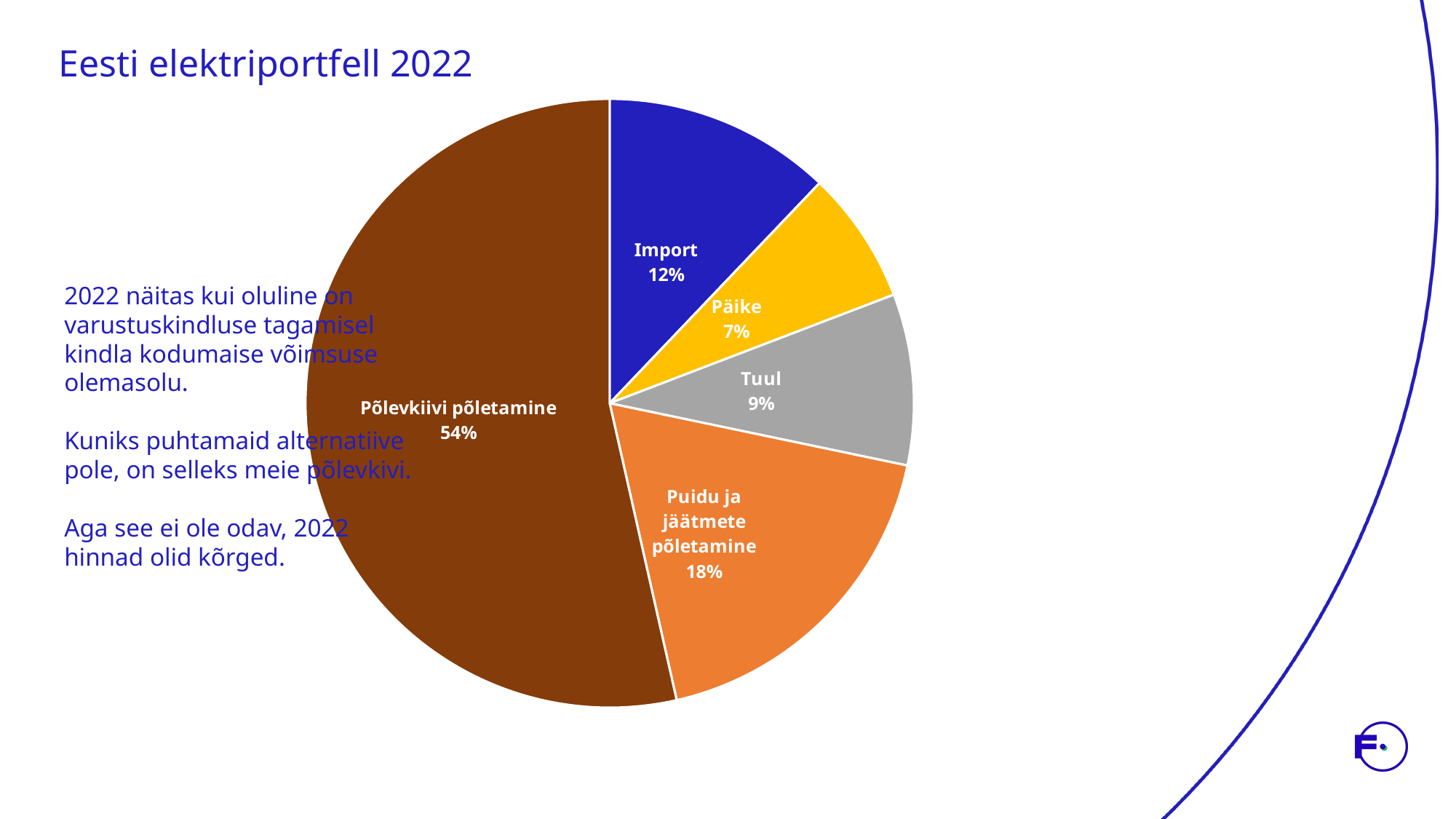
What is the value shown for Puidu ja jäätmete põletamine? 18% Which category has the largest slice of the pie? Põlevkiivi põletamine Which is larger, the share for Tuul or the share for Päike? Tuul What share of the pie does Põlevkiivi põletamine have? 54% What type of chart is shown on the slide? pie chart Which category has the smallest slice of the pie? Päike What is the difference between the shares of Põlevkiivi põletamine and Puidu ja jäätmete põletamine? 36% What is the title of the slide containing the pie chart? Eesti elektriportfell 2022 What is the value shown for Import? 12% What is the value shown for Tuul? 9% What is the difference between the shares of Import and Päike? 5% How many slices does the pie chart have? 5